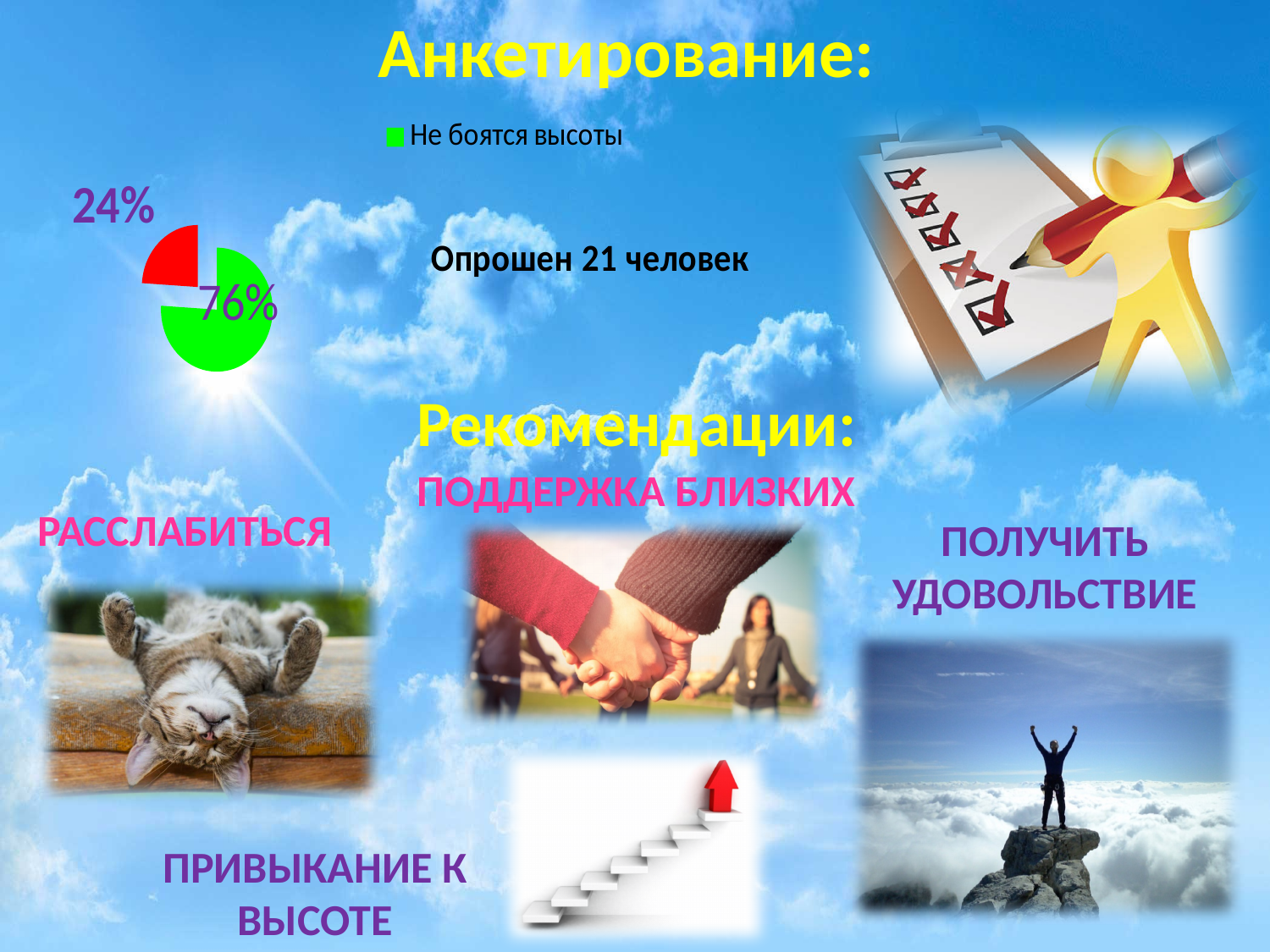
How many entries does the legend of the pie chart list? 1 Is the share of the green slice greater or less than 50%? greater What share of the pie does the red slice represent? 24% What share of the pie does the green slice (Не боятся высоты) represent? 76% Which slice of the pie chart is the smallest? the red slice, 24% What colour is the slice labelled 'Не боятся высоты' in the legend? green How many slices does the pie chart have? 2 What legend entry is shown for the pie chart? Не боятся высоты What kind of chart is shown on the slide? pie chart What is the difference in percentage points between the green slice and the red slice? 52 percentage points Which slice of the pie chart is larger, the green one or the red one? the green one Which slice of the pie chart is the largest? the green slice (Не боятся высоты), 76%